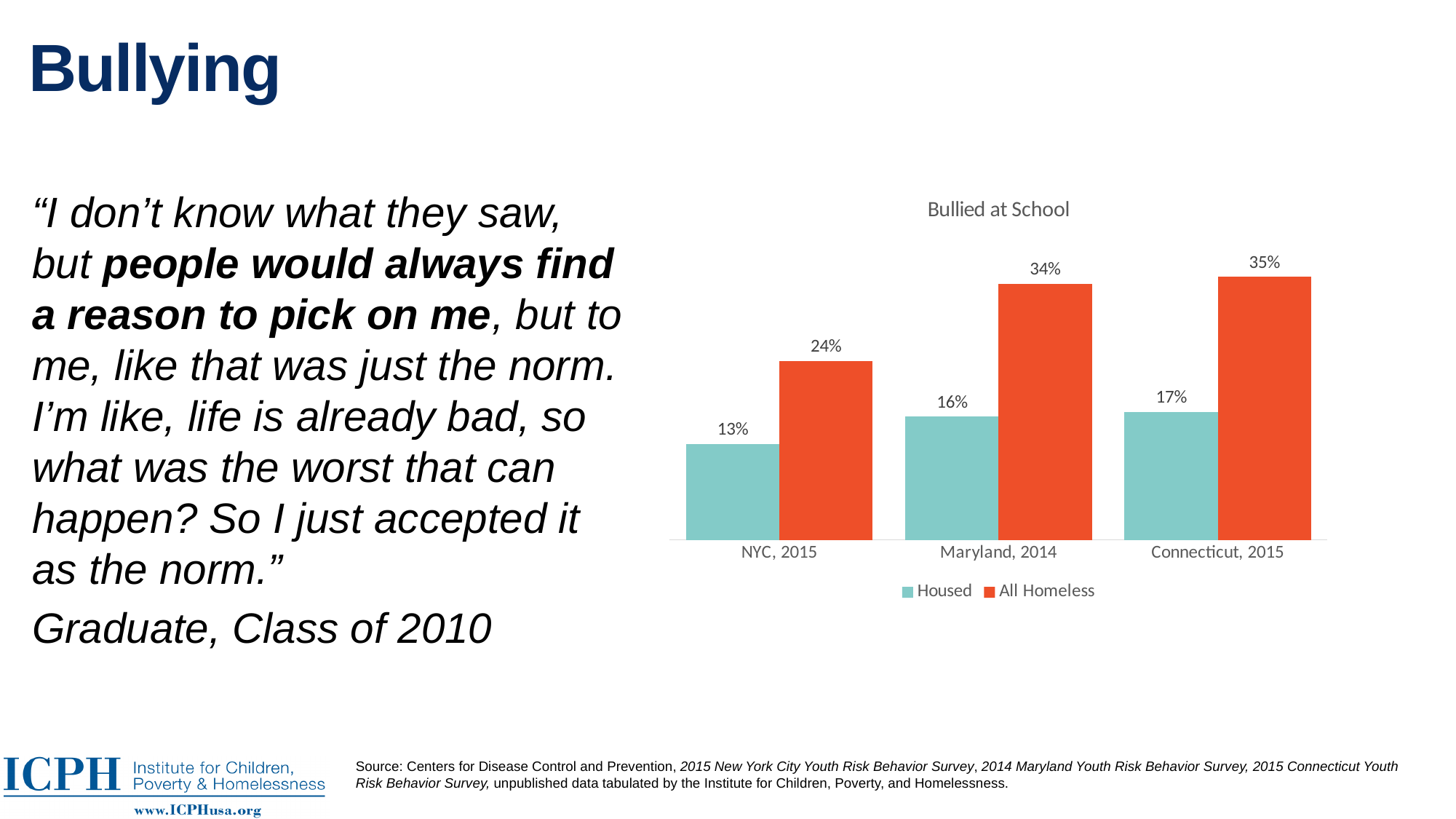
What is the difference between the All Homeless and Housed values in NYC, 2015? 11% Which category has the lowest value for Housed? NYC, 2015 What is the difference between the All Homeless and Housed values in Connecticut, 2015? 18% Which is larger: the Housed value in Connecticut, 2015 or the All Homeless value in NYC, 2015? All Homeless value in NYC, 2015 What is the value for Housed students in NYC, 2015? 13% What is the value for All Homeless students in Connecticut, 2015? 35% Which category has the highest value for All Homeless? Connecticut, 2015 What is the value for All Homeless students in Maryland, 2014? 34% How many series does the legend list? 2 What is the value for Housed students in Maryland, 2014? 16% What type of chart is shown on the slide? Bar chart How many categories are shown on the x axis? 3